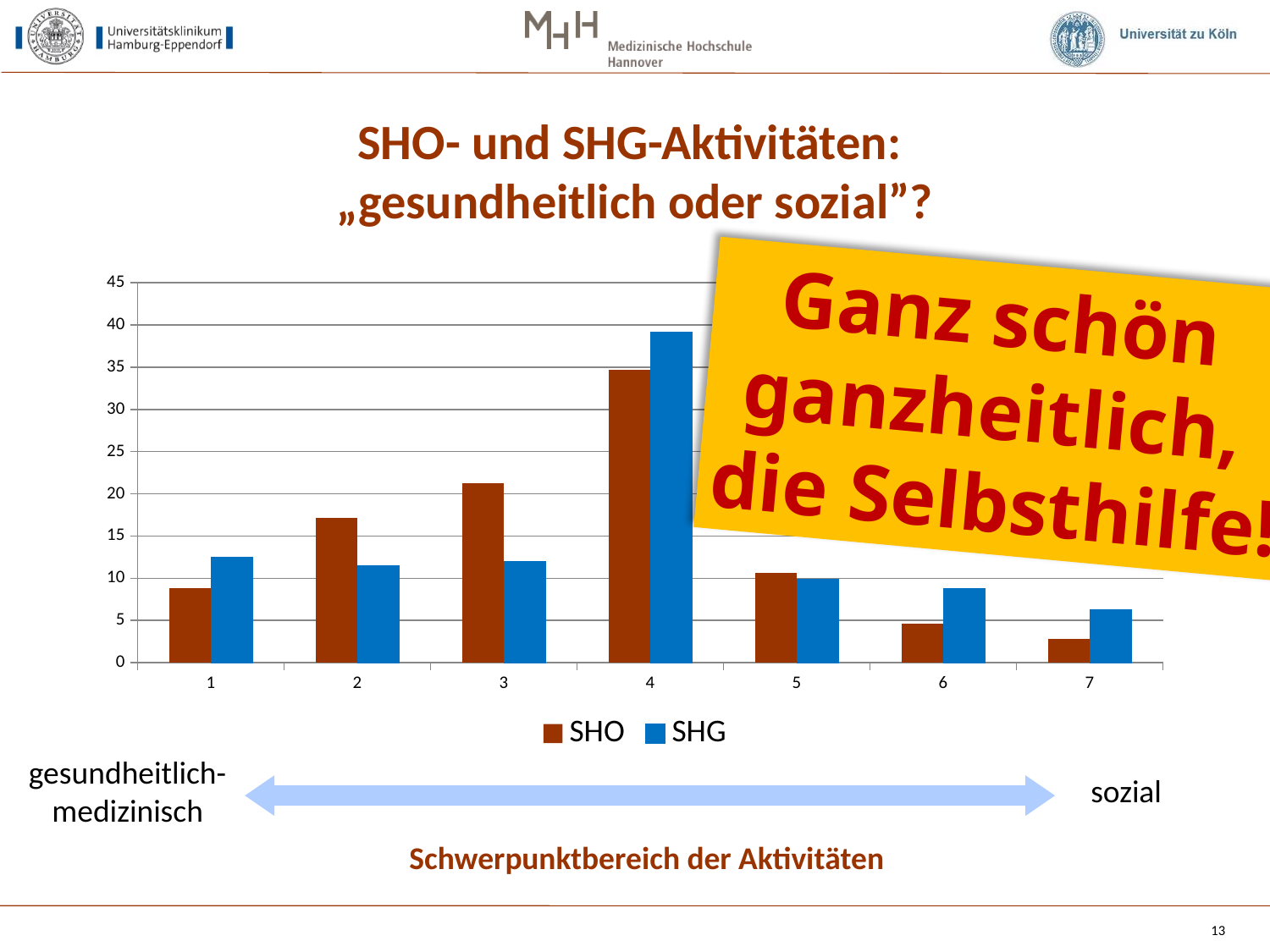
Is the SHG value for category 4 greater or less than 35? greater For which category is the SHG value highest? 4 What are the two series named in the chart legend? SHO and SHG What kind of chart is shown on the slide? bar chart For category 1, which series has the larger value, SHO or SHG? SHG For which category is the SHO value highest? 4 Is the SHO value for category 2 greater or less than 15? greater For category 3, which series has the larger value, SHO or SHG? SHO How many series does the chart legend list? 2 Is the SHO value for category 7 greater or less than 5? less For which category is the SHO value lowest? 7 How many categories are shown on the x axis of the chart? 7